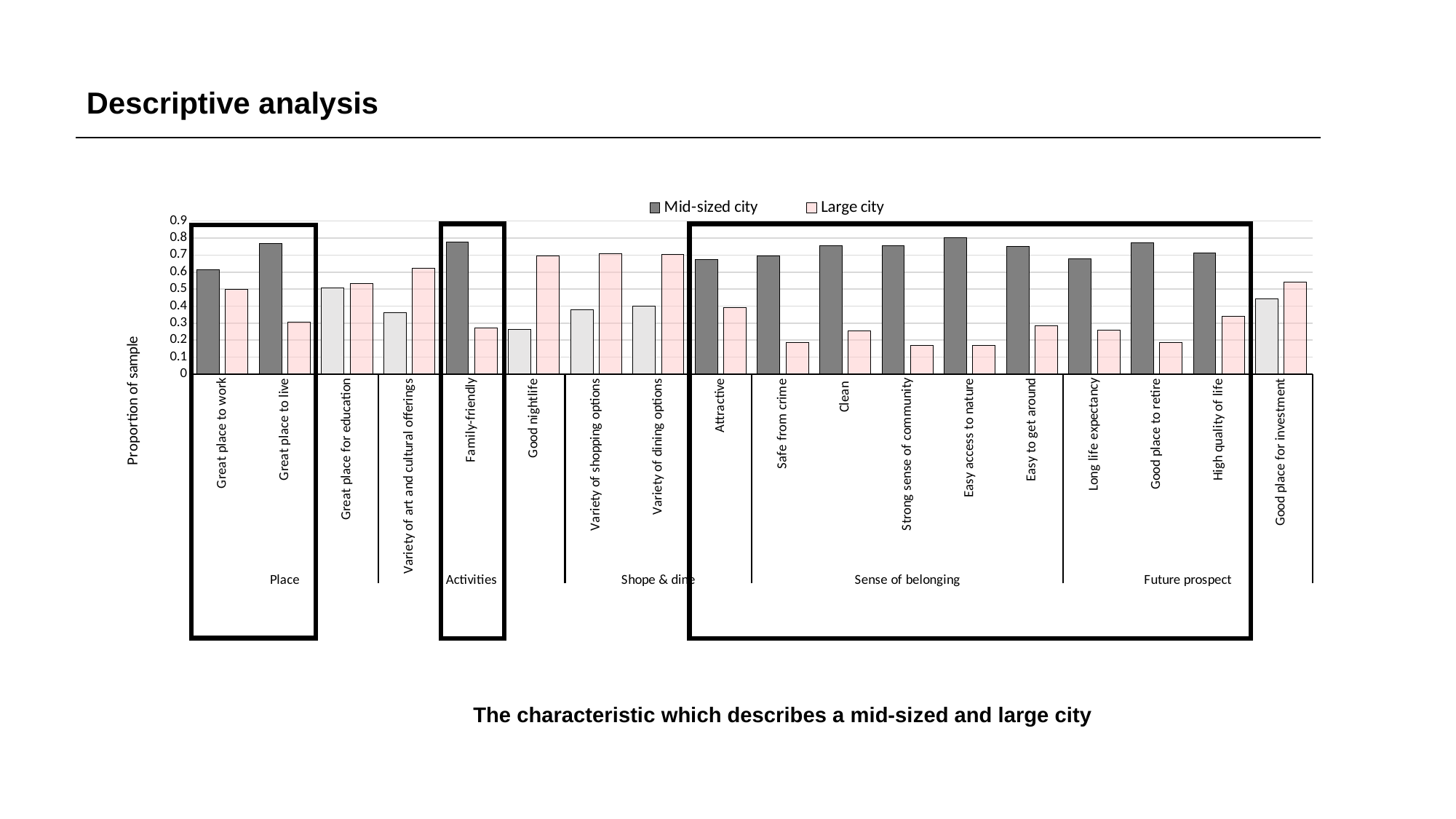
Which series has the larger value for Good place for investment, Mid-sized city or Large city? Large city Is the Large city value for Good nightlife greater or less than 0.6? greater Is the Large city value for Safe from crime greater or less than 0.3? less What is the label on the y axis? Proportion of sample How many series does the legend list? 2 Which series has the larger value for Good nightlife, Mid-sized city or Large city? Large city Is the Mid-sized city value for Good nightlife greater or less than 0.3? less Which series has the larger value for Family-friendly, Mid-sized city or Large city? Mid-sized city What kind of chart is shown on the slide? Bar chart For which characteristic is the Mid-sized city value lowest? Good nightlife How many characteristics (categories) are plotted along the x axis? 18